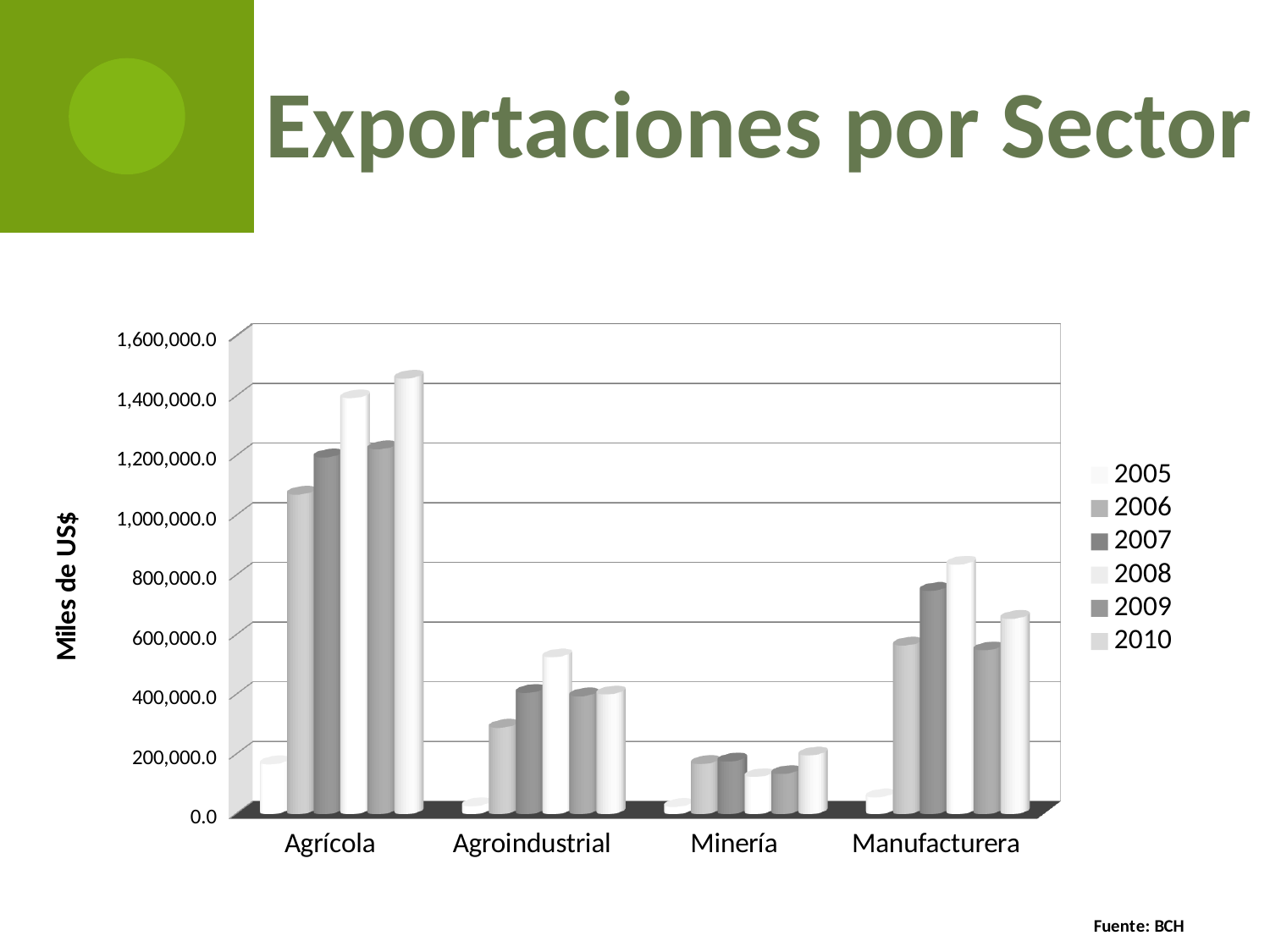
What is the title of the vertical axis? Miles de US$ How many sectors are shown on the x axis of the chart? 4 For the Agrícola sector, which year has the highest bar? 2010 Is the value for Agroindustrial in 2008 greater or less than 400,000.0? greater Is the value for Manufacturera in 2010 greater or less than 600,000.0? greater Which sector has the highest export values overall? Agrícola Is the value for Agrícola in 2005 greater or less than 200,000.0? less How many series does the legend list? 6 What kind of chart is shown on the slide? bar chart Which sector has the lowest export values overall? Minería Which is larger in 2008: Agroindustrial or Manufacturera? Manufacturera For the Agrícola sector, which year has the lowest bar? 2005